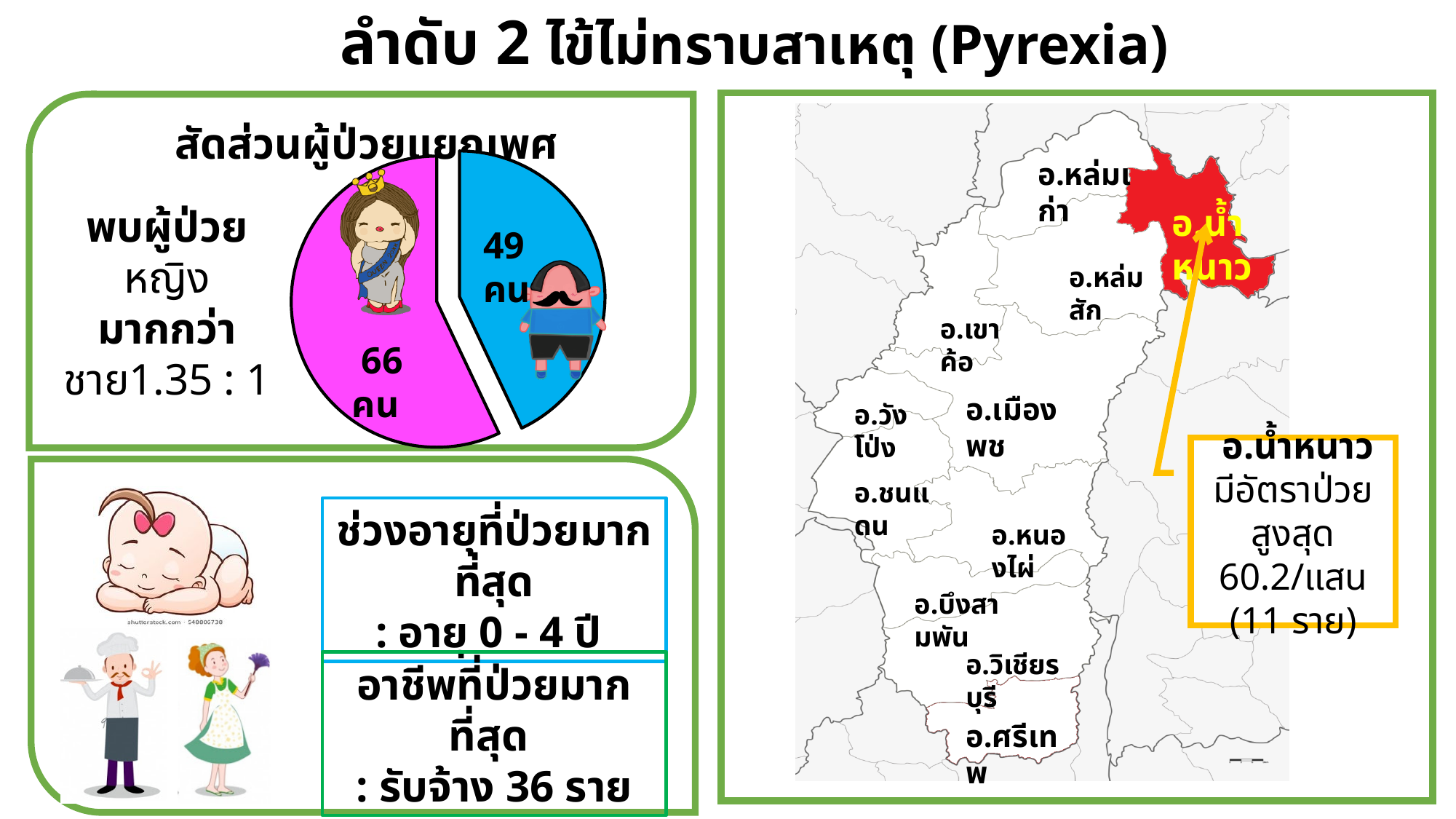
In the pie chart, how many patients are male (ชาย)? 49 คน Which sex has the smaller slice in the pie chart? ชาย (male) Which sex has the larger slice in the pie chart? หญิง (female) What is the difference between the number of female and male patients in the pie chart? 17 Is the number of female patients in the pie chart greater or less than the number of male patients? greater What ratio of female to male patients is stated next to the pie chart? 1.35 : 1 What colour is the slice representing female patients in the pie chart? pink (magenta) What is the total number of patients shown in the pie chart? 115 In the pie chart, how many patients are female (หญิง)? 66 คน What kind of chart is shown in the 'สัดส่วนผู้ป่วยแยกเพศ' panel? pie chart How many slices does the pie chart have? 2 What is the title of the pie chart? สัดส่วนผู้ป่วยแยกเพศ